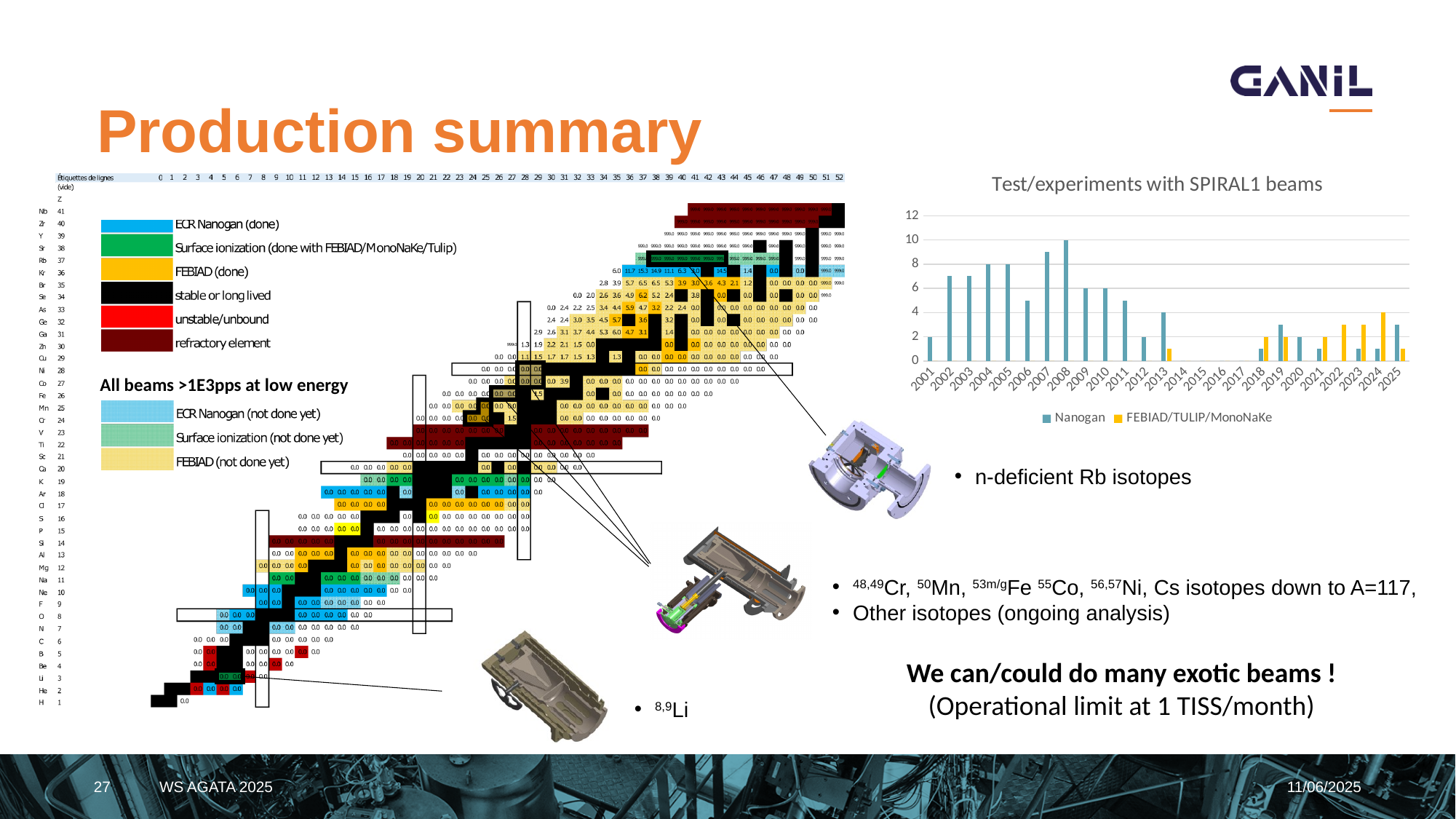
In the 'Test/experiments with SPIRAL1 beams' chart, which year has the highest Nanogan value? 2008 In the 'Test/experiments with SPIRAL1 beams' chart, what kind of chart is shown? bar chart In the 'Test/experiments with SPIRAL1 beams' chart, what is the Nanogan value for 2008? 10 In the 'Test/experiments with SPIRAL1 beams' chart, is the Nanogan value for 2006 greater or less than 6? less In the 'Test/experiments with SPIRAL1 beams' chart, how many series does the legend list? 2 In the 'Test/experiments with SPIRAL1 beams' chart, what is the Nanogan value for 2001? 2 What is the title of the bar chart on the right of the slide? Test/experiments with SPIRAL1 beams In the 'Test/experiments with SPIRAL1 beams' chart, do the Nanogan values rise or fall from 2008 to 2012? fall In the 'Test/experiments with SPIRAL1 beams' chart, is the Nanogan value for 2007 greater or less than 8? greater In the 'Test/experiments with SPIRAL1 beams' chart, which is larger, the Nanogan value for 2004 or the Nanogan value for 2012? 2004 In the 'Test/experiments with SPIRAL1 beams' chart, how many years are shown on the x axis? 25 In the 'Test/experiments with SPIRAL1 beams' chart, which two series are listed in the legend? Nanogan and FEBIAD/TULIP/MonoNaKe